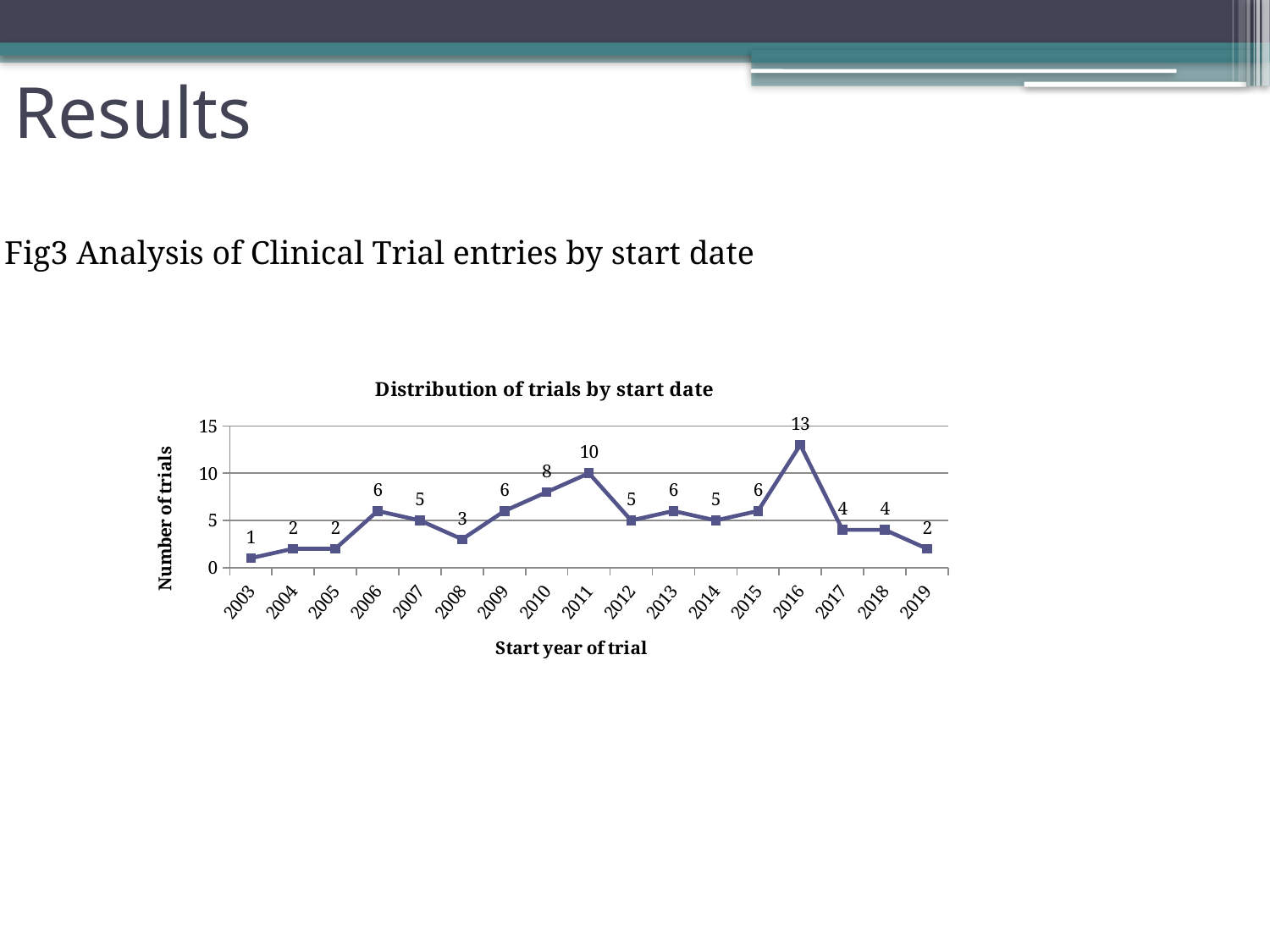
What is the difference in the number of trials between 2016 and 2017? 9 Which year had more trials, 2010 or 2012? 2010 How many start years are plotted on the x axis? 17 What is the number of trials that started in 2003? 1 What is the label of the y axis? Number of trials Which start year has the lowest number of trials? 2003 What is the title of the chart? Distribution of trials by start date What is the number of trials that started in 2011? 10 What type of chart is shown on the slide? line chart Does the number of trials rise or fall from 2016 to 2019? fall Which start year has the highest number of trials? 2016 What is the number of trials that started in 2016? 13